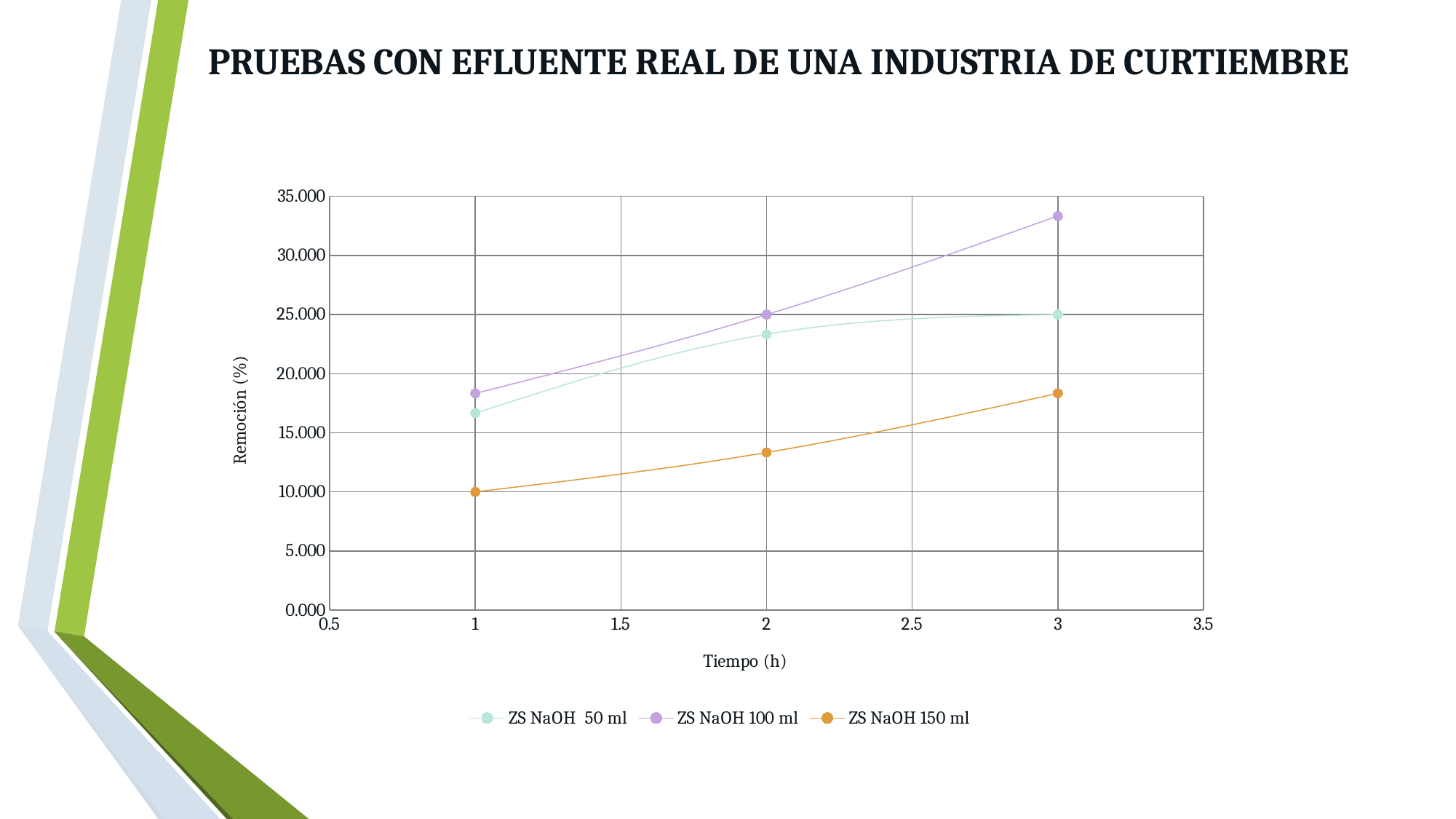
What kind of chart is shown on the slide? Line chart What is the value for ZS NaOH 50 ml at 3 h? 25.000 Which series has the highest value at 3 h? ZS NaOH 100 ml At 2 h, which is larger: the value for ZS NaOH 50 ml or for ZS NaOH 150 ml? ZS NaOH 50 ml How many data points are plotted for the ZS NaOH 150 ml series? 3 How many series does the legend list? 3 Is the value for ZS NaOH 100 ml at 3 h greater or less than 30.000? greater Which series has the lowest value at 2 h? ZS NaOH 150 ml What is the value for ZS NaOH 150 ml at 1 h? 10.000 What is the value for ZS NaOH 100 ml at 2 h? 25.000 Do the values for ZS NaOH 150 ml rise or fall as time increases from 1 h to 3 h? rise Is the value for ZS NaOH 150 ml at 3 h greater or less than 20.000? less